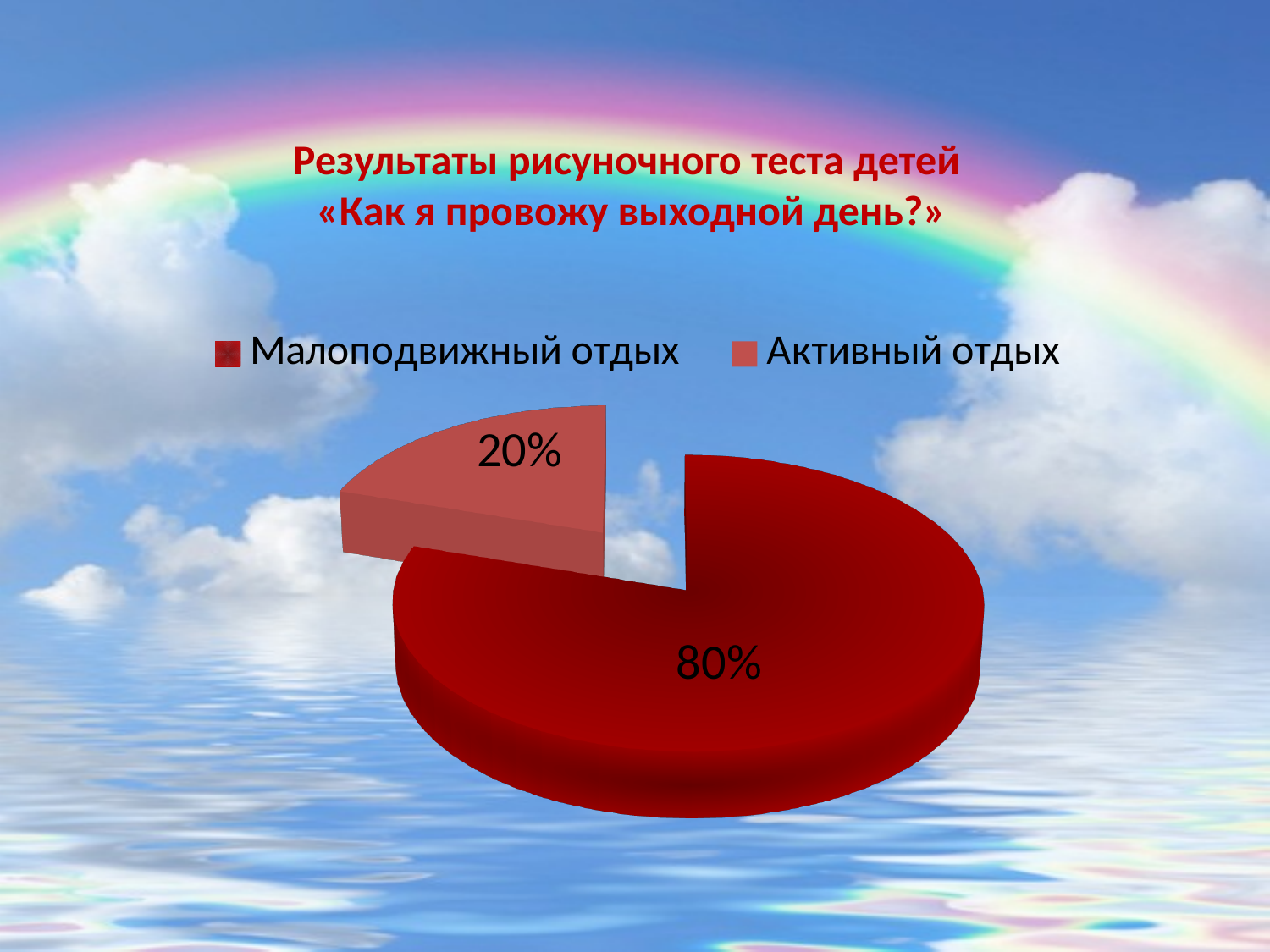
How many slices does the pie chart have? 2 Which category has the largest slice of the pie? Малоподвижный отдых What share of the pie does Активный отдых have? 20% What kind of chart is shown on the slide? pie chart What is the difference in percentage points between Малоподвижный отдых and Активный отдых? 60 Which legend entry is shown in the lighter red colour? Активный отдых Which is larger, the slice for Малоподвижный отдых or the slice for Активный отдых? Малоподвижный отдых How many entries does the legend list? 2 Which category has the smallest slice of the pie? Активный отдых What is the title of the chart on the slide? Результаты рисуночного теста детей «Как я провожу выходной день?» What share of the pie does Малоподвижный отдых have? 80%